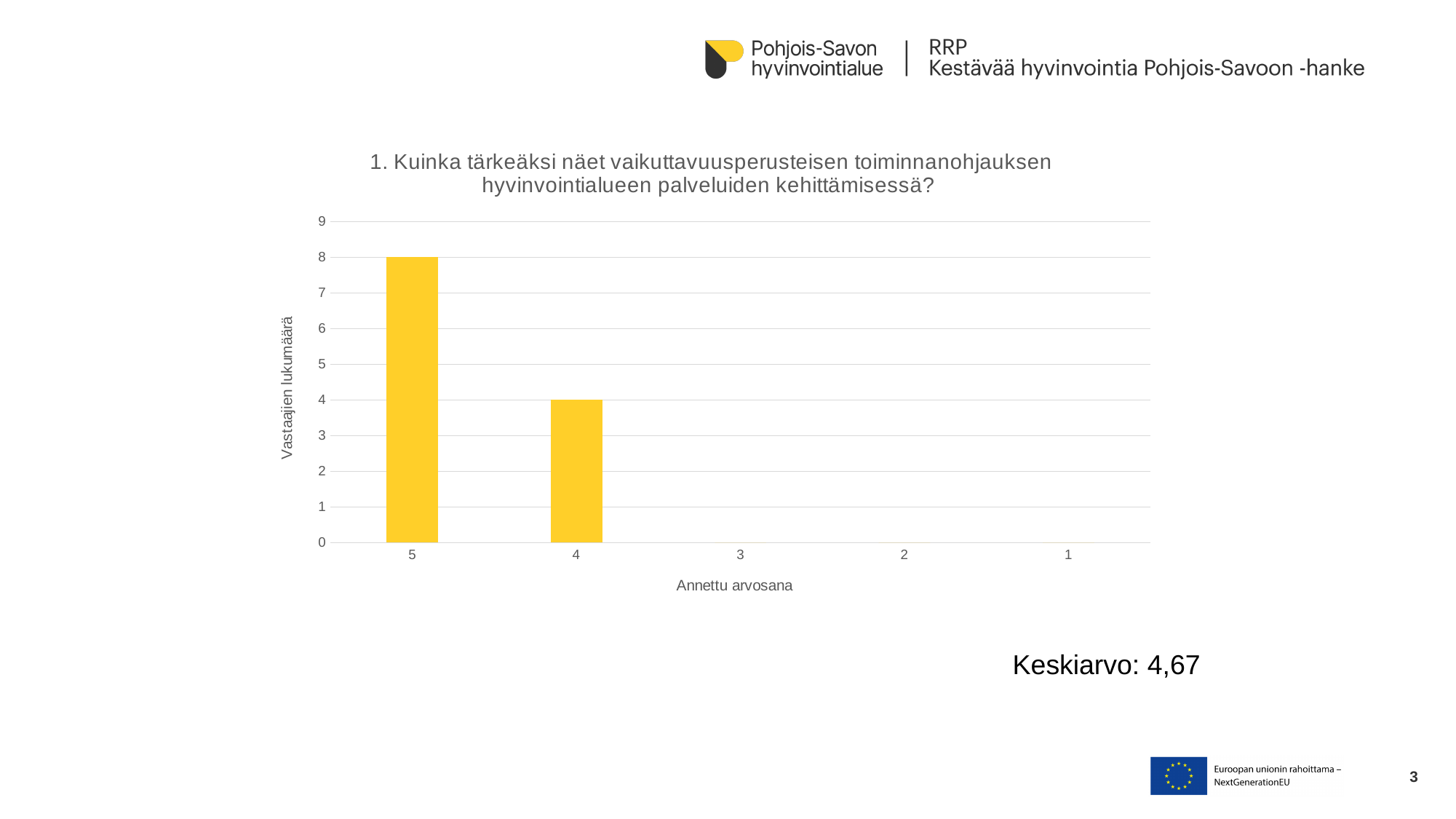
How many respondents gave the rating 5? 8 Is the value for rating 4 greater or less than 6? less What is the label of the y axis? Vastaajien lukumäärä What is the label of the x axis? Annettu arvosana What kind of chart is shown on the slide? bar chart Which rating category has the highest number of respondents? 5 What is the highest value shown on the y axis? 9 How many respondents gave the rating 4? 4 What is the difference between the number of respondents who gave rating 5 and those who gave rating 4? 4 How many rating categories are shown on the x axis? 5 Is the value for rating 5 greater or less than 6? greater Which has more respondents, rating 5 or rating 4? 5